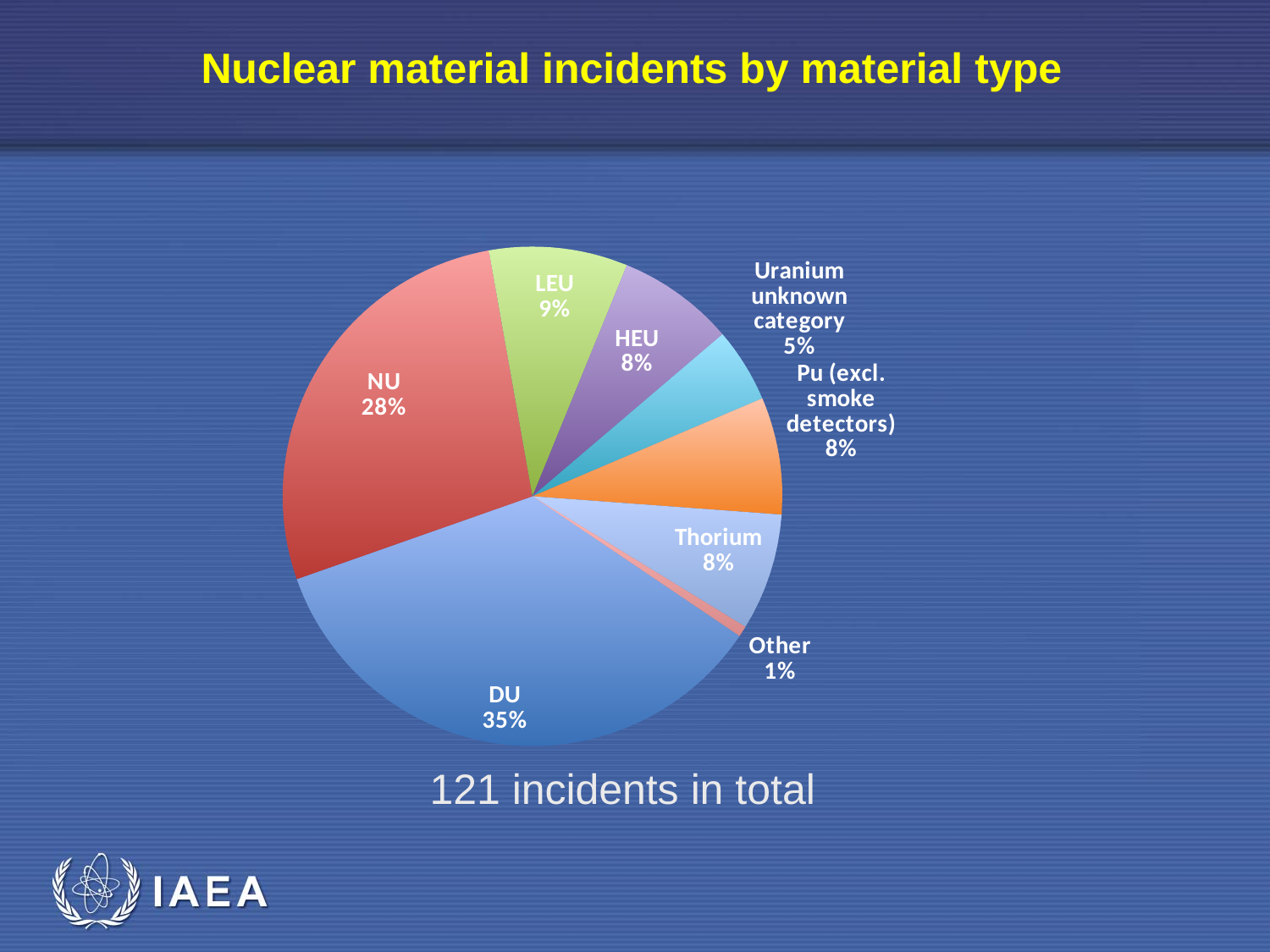
How many material type categories are shown in the pie chart? 8 What is the difference in percentage points between the DU and NU shares? 7 Which has a larger share of incidents, LEU or HEU? LEU Which material type accounts for the smallest share of incidents? Other What share of incidents involved LEU? 9% What share of incidents involved Uranium unknown category? 5% Which material type accounts for the largest share of incidents? DU What share of nuclear material incidents involved DU? 35% How many incidents in total does the slide say the chart covers? 121 What kind of chart is shown on the slide? pie chart